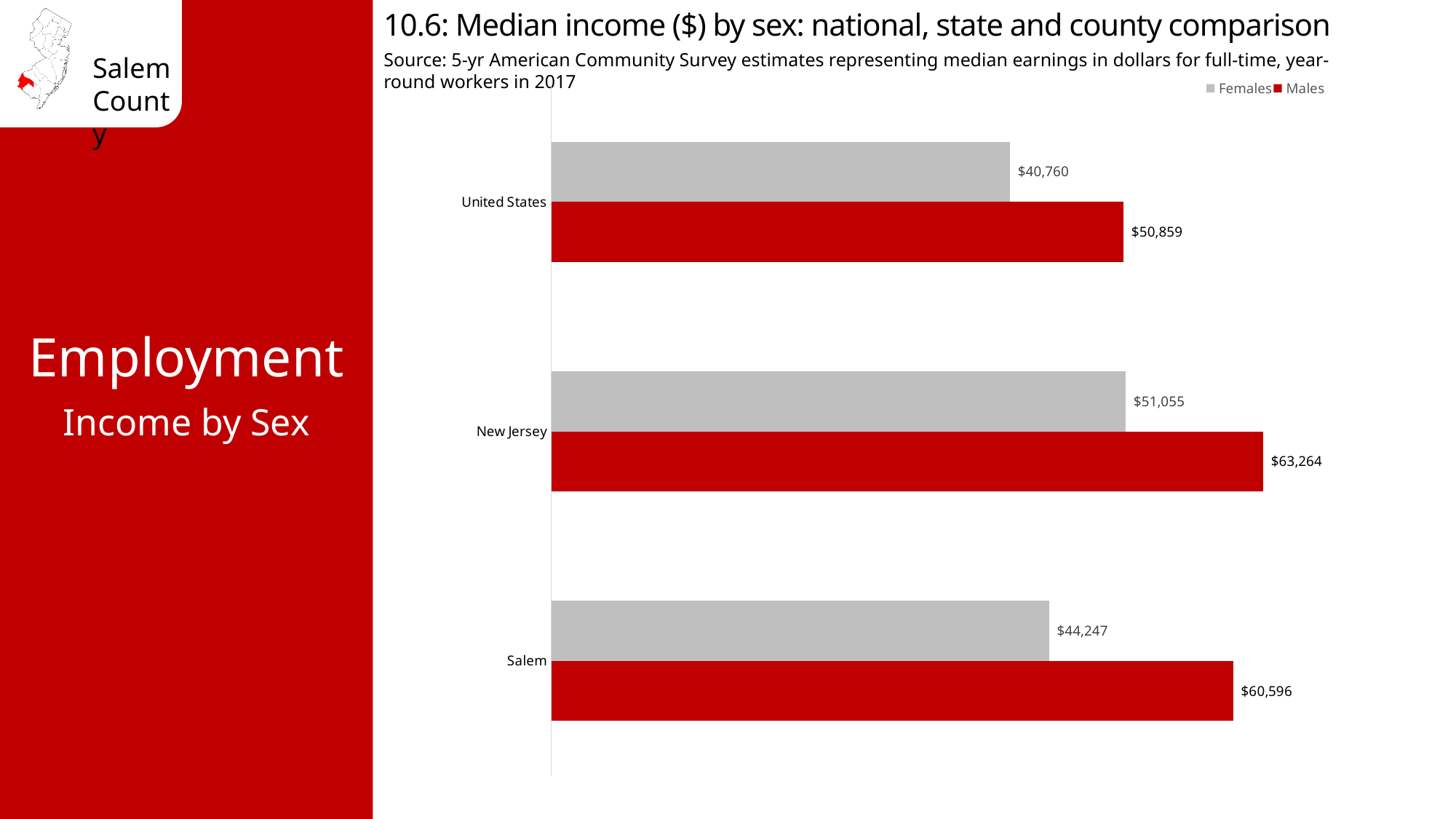
What is the median income for Males in New Jersey? $63,264 What colour represents the Males series in the chart? Red What is the median income for Males in Salem? $60,596 What is the median income for Females in the United States? $40,760 How many series does the legend list? 2 Which category has the lowest median income for Females? United States Which category has the highest median income for Males? New Jersey What kind of chart is shown on the slide? Bar chart What is the median income for Females in Salem? $44,247 How many categories are shown on the chart? 3 What is the difference between Males and Females median income in Salem? $16,349 Which is larger: the Females median income in New Jersey or the Males median income in the United States? Females median income in New Jersey